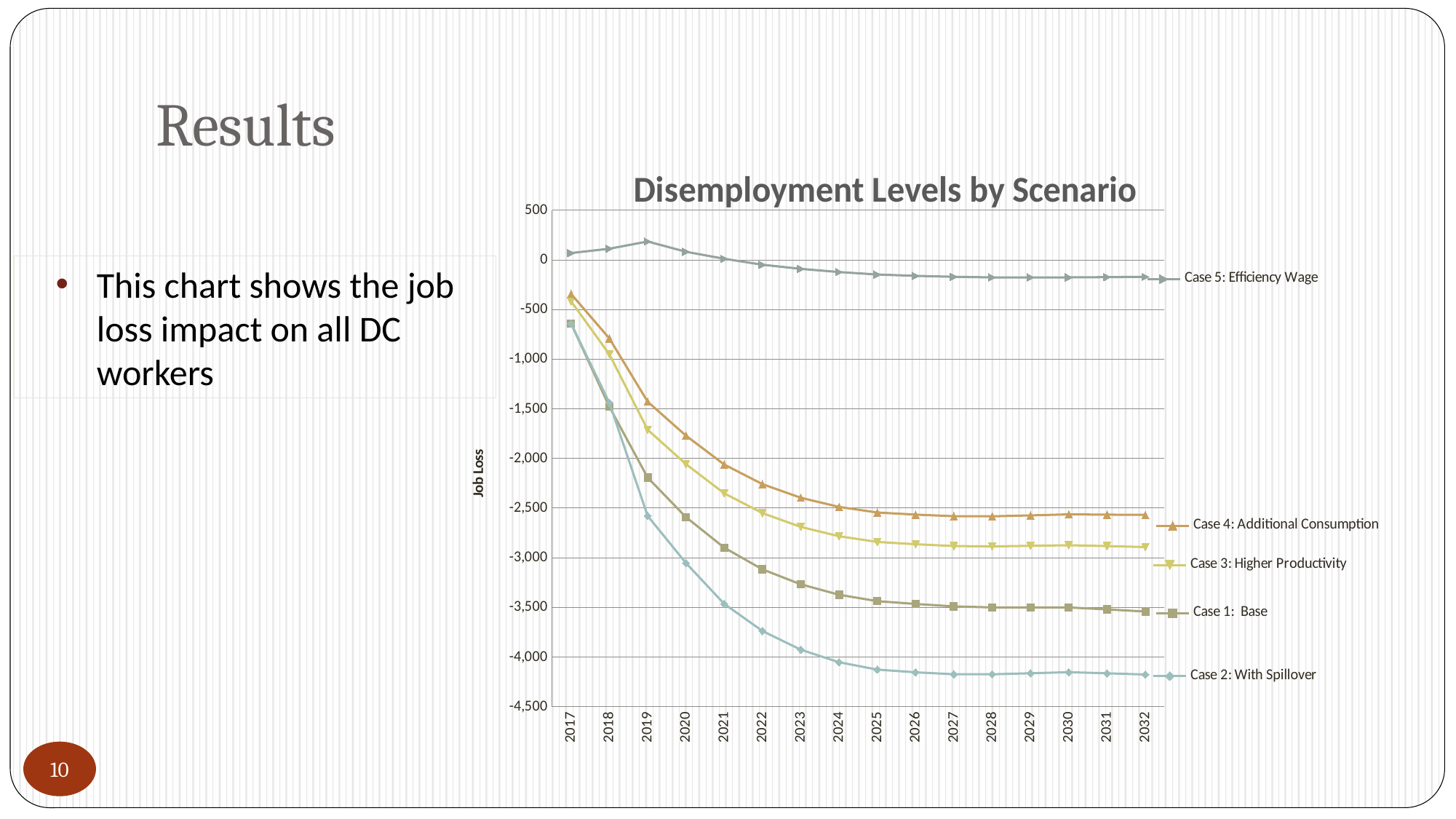
What is the label of the vertical axis? Job Loss Which series has the highest values across the chart? Case 5: Efficiency Wage How many years are plotted along the x axis? 16 Is the value for Case 5: Efficiency Wage in 2019 greater or less than 0? greater Is the value for Case 3: Higher Productivity in 2025 greater or less than -2,500? less Which series has the lowest values across the chart? Case 2: With Spillover How many series does the chart show? 5 In 2032, which is larger: the value for Case 4: Additional Consumption or Case 3: Higher Productivity? Case 4: Additional Consumption What kind of chart is shown on the slide? line chart Is the value for Case 2: With Spillover in 2032 greater or less than -4,000? less What is the title of the chart? Disemployment Levels by Scenario Does the Case 2: With Spillover line rise or fall from 2017 to 2025? fall